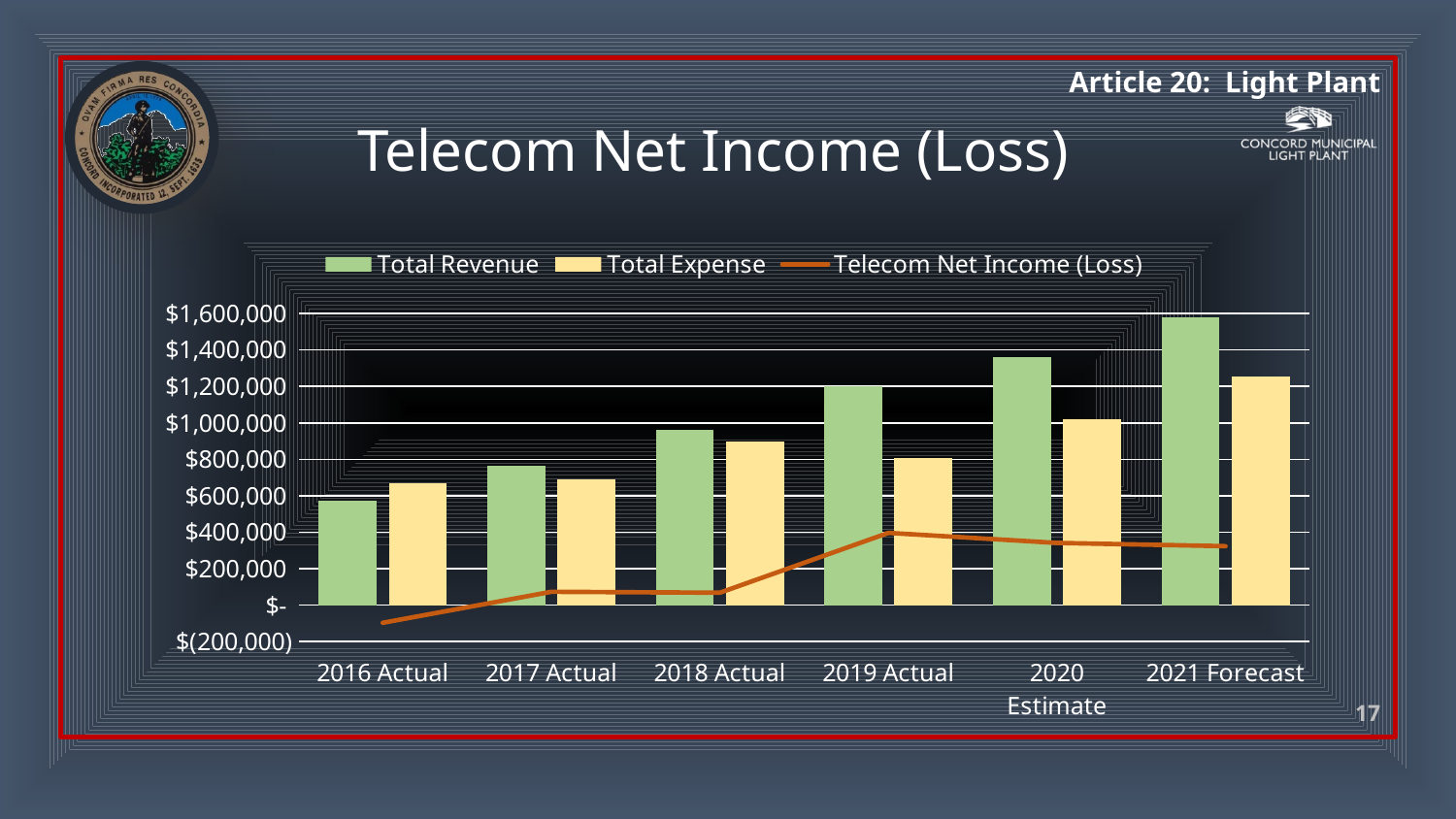
How many categories are shown on the x axis? 6 Which category has the highest Total Revenue? 2021 Forecast Is the Total Revenue for 2016 Actual greater or less than $800,000? less Does Total Revenue rise or fall from 2016 Actual to 2021 Forecast? rise For 2016 Actual, which is larger: Total Revenue or Total Expense? Total Expense In which category does the Telecom Net Income (Loss) line reach its highest point? 2019 Actual Is the Total Expense for 2019 Actual greater or less than $1,000,000? less For 2019 Actual, which is larger: Total Revenue or Total Expense? Total Revenue How many series does the legend list? 3 Which category has the lowest Total Revenue? 2016 Actual What kind of chart is shown on the slide? bar and line chart Is the Total Revenue for 2021 Forecast greater or less than $1,400,000? greater